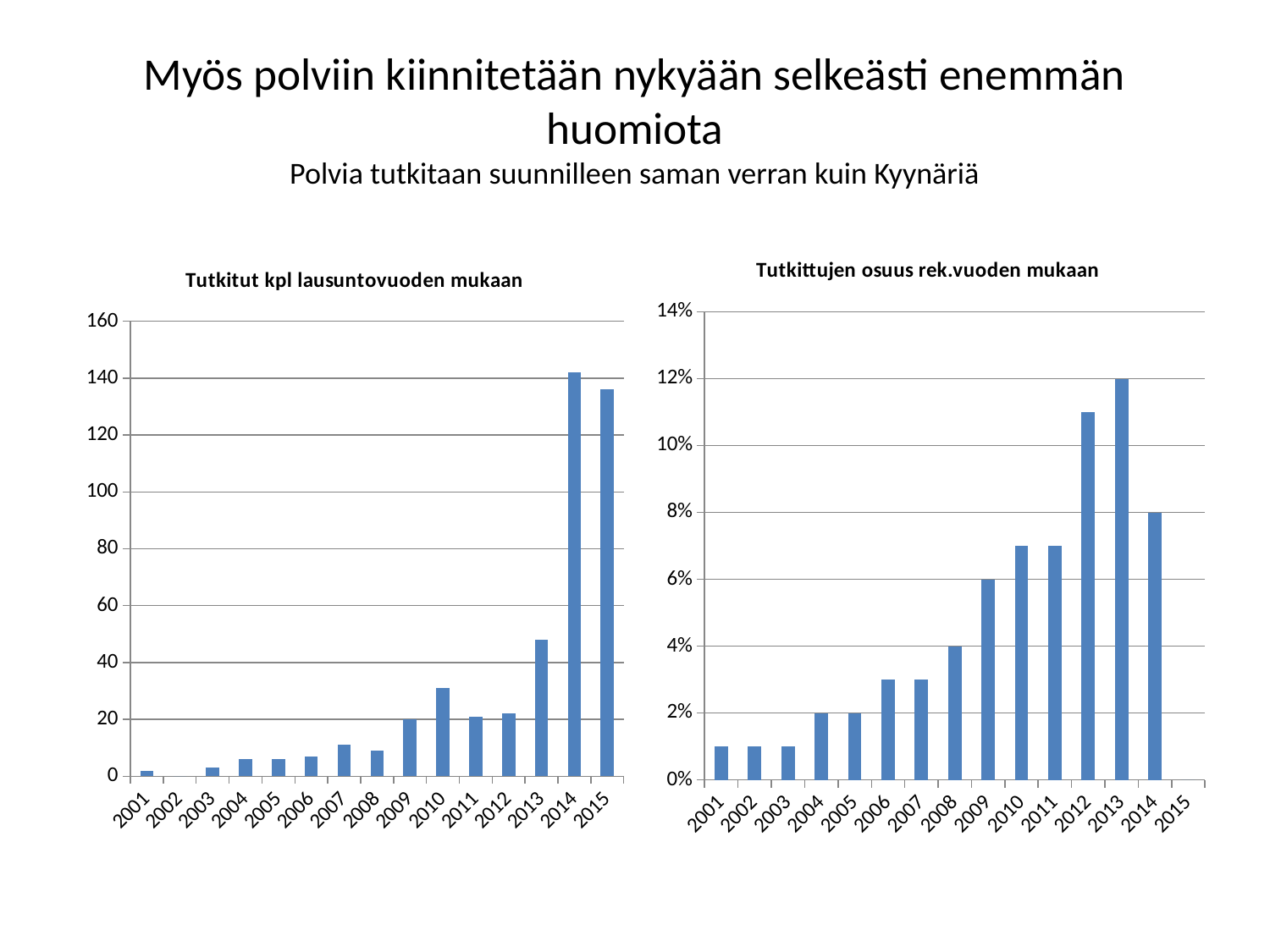
In the right chart "Tutkittujen osuus rek.vuoden mukaan", is the value for 2012 greater or less than 10%? greater How many years are shown on the x axis of the left chart "Tutkitut kpl lausuntovuoden mukaan"? 15 In the right chart "Tutkittujen osuus rek.vuoden mukaan", what is the value for 2013? 12% In the right chart "Tutkittujen osuus rek.vuoden mukaan", do the values generally rise or fall from 2001 to 2013? rise In the left chart "Tutkitut kpl lausuntovuoden mukaan", is the value for 2015 greater or less than 120? greater In the right chart "Tutkittujen osuus rek.vuoden mukaan", which year has the highest value? 2013 What kind of chart is the left chart titled "Tutkitut kpl lausuntovuoden mukaan"? bar chart In the left chart "Tutkitut kpl lausuntovuoden mukaan", is the value for 2013 greater or less than 60? less In the right chart "Tutkittujen osuus rek.vuoden mukaan", what is the value for 2014? 8% In the left chart "Tutkitut kpl lausuntovuoden mukaan", which year has the larger value, 2010 or 2011? 2010 In the right chart "Tutkittujen osuus rek.vuoden mukaan", what is the value for 2009? 6% In the left chart "Tutkitut kpl lausuntovuoden mukaan", which year has the highest value? 2014